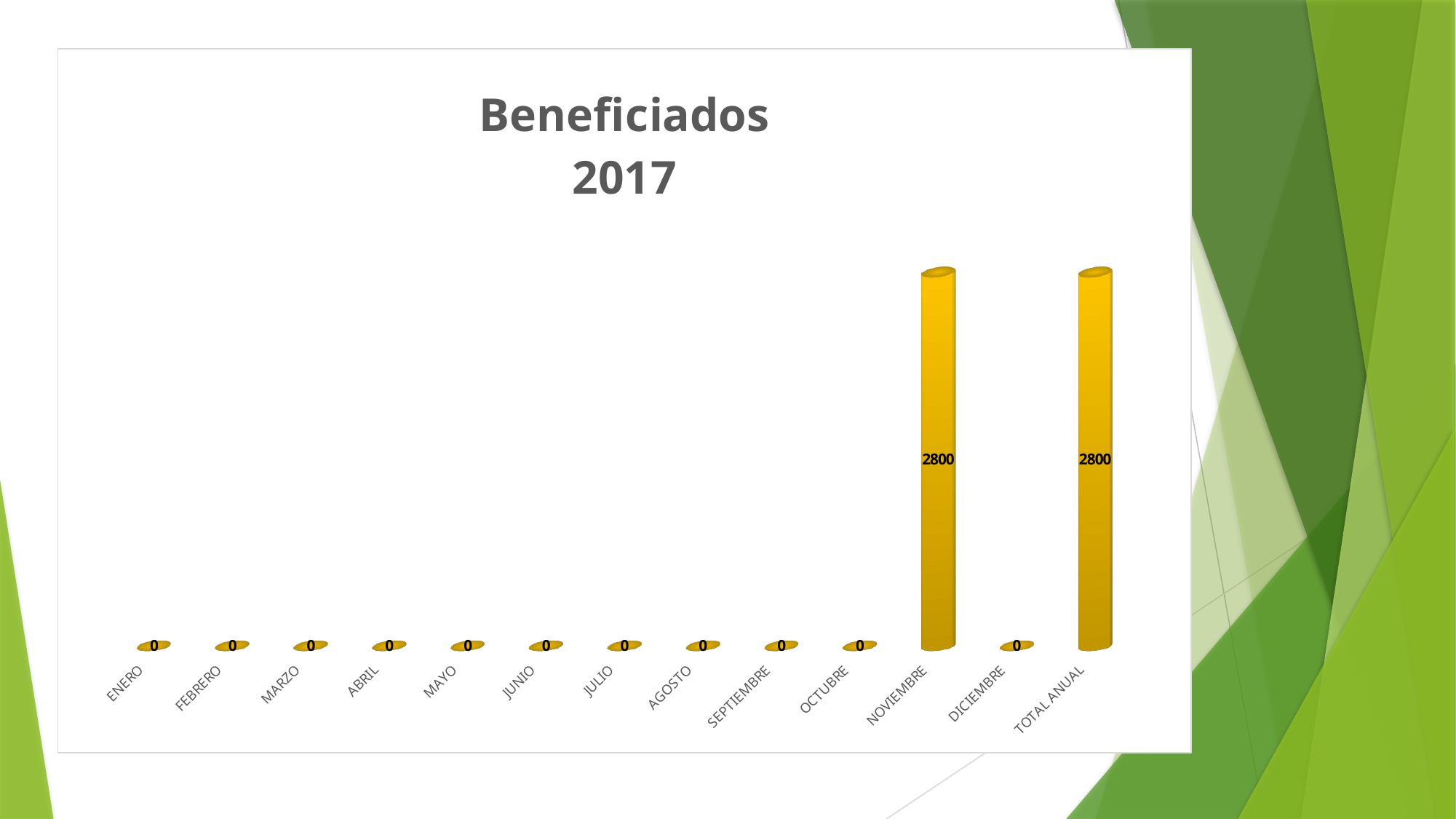
What is the value for DICIEMBRE? 0 What is the value for ENERO? 0 What is the value for NOVIEMBRE? 2800 How many months have a value of 0? 11 What is the value for TOTAL ANUAL? 2800 What is the title of the chart? Beneficiados 2017 Which month has the highest value? NOVIEMBRE Which is larger, the value for NOVIEMBRE or the value for DICIEMBRE? NOVIEMBRE How many categories are shown on the x axis? 13 What is the difference between the values for NOVIEMBRE and OCTUBRE? 2800 What colour are the bars in the chart? yellow What kind of chart is shown? bar chart